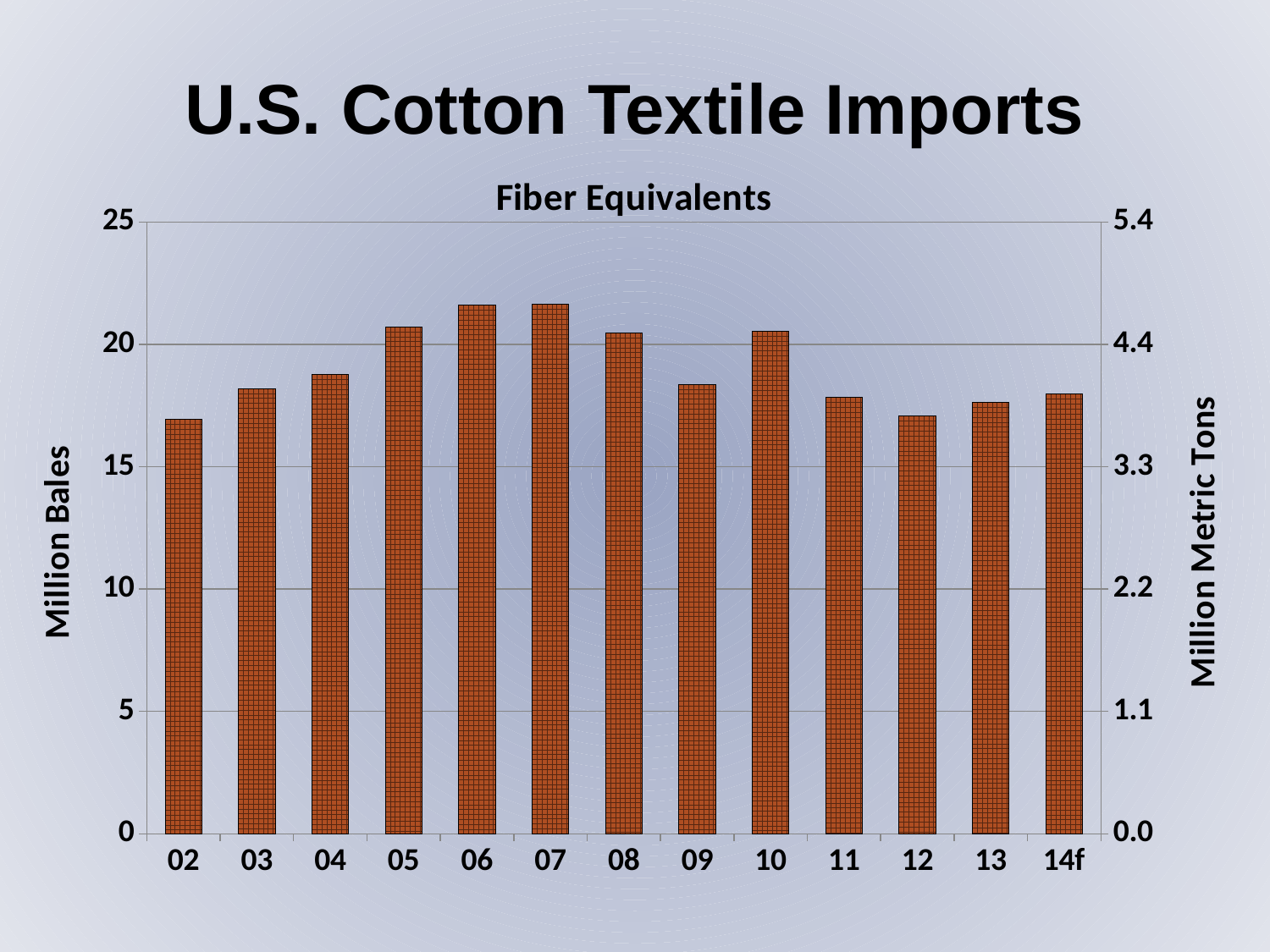
Is the value for 06 greater or less than 20 million bales? greater What is the label on the left vertical axis? Million Bales Which has the larger value, 05 or 04? 05 Which has the larger value, 10 or 11? 10 Is the value for 09 greater or less than 15 million bales? greater Is the value for 12 greater or less than 20 million bales? less Do the values rise or fall from 02 to 06? rise What is the label on the right vertical axis? Million Metric Tons What kind of chart is shown on the slide? bar chart How many years (categories) are plotted on the x axis? 13